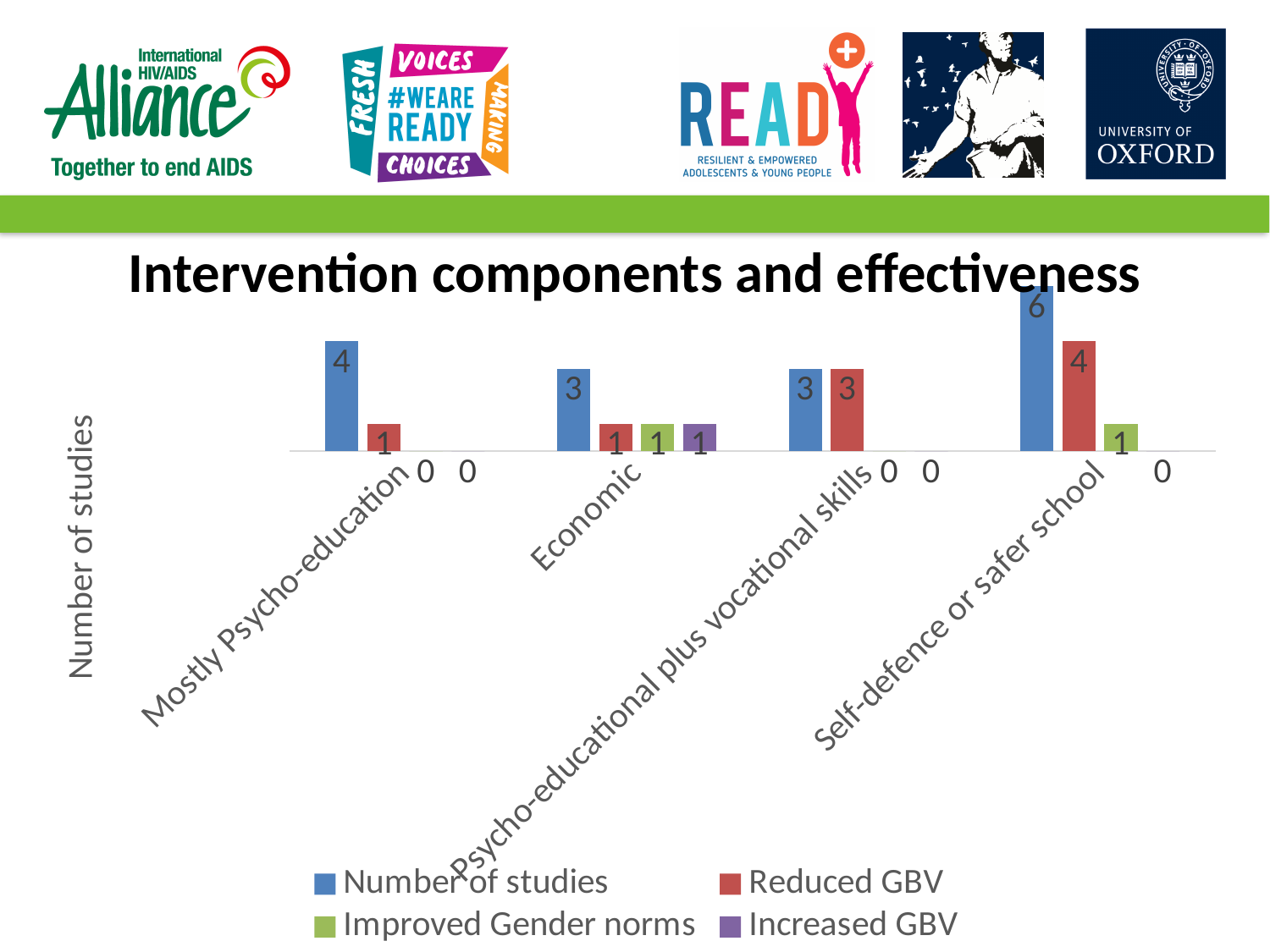
Which category has the lowest Reduced GBV value? Mostly Psycho-education and Economic (both 1) Which is larger for Mostly Psycho-education: Number of studies or Reduced GBV? Number of studies What is the Number of studies for Self-defence or safer school? 6 What kind of chart is shown on the slide? bar chart What is the difference between the Number of studies and the Reduced GBV value for Self-defence or safer school? 2 How many intervention categories are shown on the x axis? 4 What is the label of the vertical axis? Number of studies How many series does the legend list? 4 What is the Increased GBV value for Economic? 1 What is the Reduced GBV value for Psycho-educational plus vocational skills? 3 Which category has the highest Number of studies? Self-defence or safer school What is the Improved Gender norms value for Mostly Psycho-education? 0